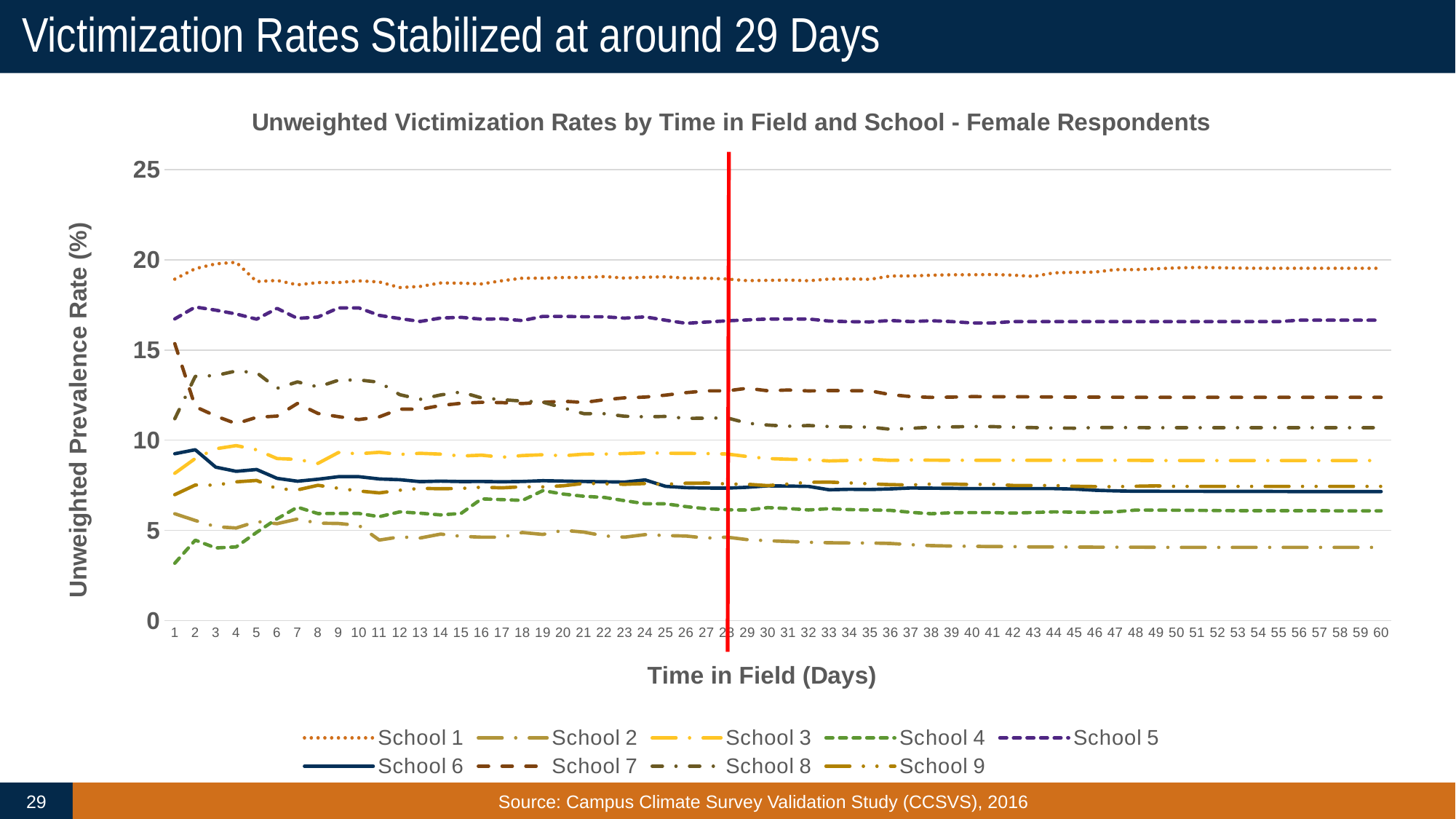
Which school has the lowest victimization rate at day 60? School 2 What kind of chart is shown on the slide? Line chart What is the title of the chart? Unweighted Victimization Rates by Time in Field and School - Female Respondents Is the value for School 1 at day 60 greater or less than 15? greater Does the value for School 6 rise or fall from day 1 to day 60? Fall Is the value for School 6 at day 60 greater or less than 10? less Is the value for School 7 at day 60 greater or less than 10? greater At day 60, which is higher, School 7 or School 8? School 7 How many days (points) are shown along the x axis? 60 How many series does the legend list? 9 Which school has the highest victimization rate across the time in field? School 1